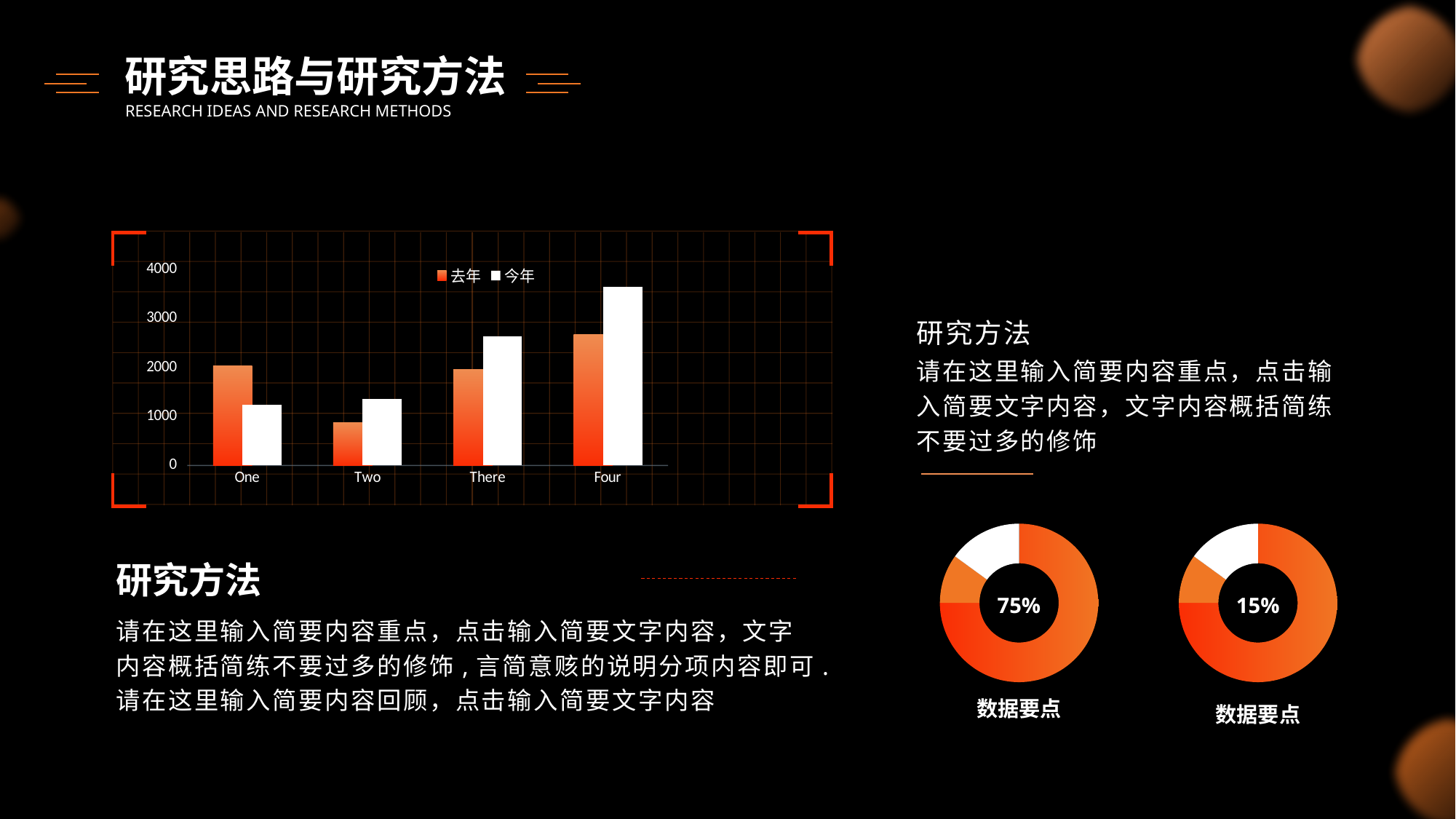
What kind of chart is the chart on the left side of the slide? bar chart What percentage is shown in the centre of the left donut chart at the bottom right of the slide? 75% In the bar chart, for category One, which series has the larger value, 去年 or 今年? 去年 What are the two legend entries in the bar chart? 去年 and 今年 In the bar chart, how many categories are shown on the x axis? 4 In the bar chart, which category has the lowest value for 去年? Two In the bar chart, how many series does the legend list? 2 In the bar chart, is the 今年 value for Four greater or less than 3000? greater In the bar chart, which category has the highest value for 今年? Four In the bar chart, is the 去年 value for Two greater or less than 1000? less In the bar chart, which is larger: the 今年 value for There or the 今年 value for Four? Four In the bar chart, do the 今年 values rise or fall from One to Four? rise